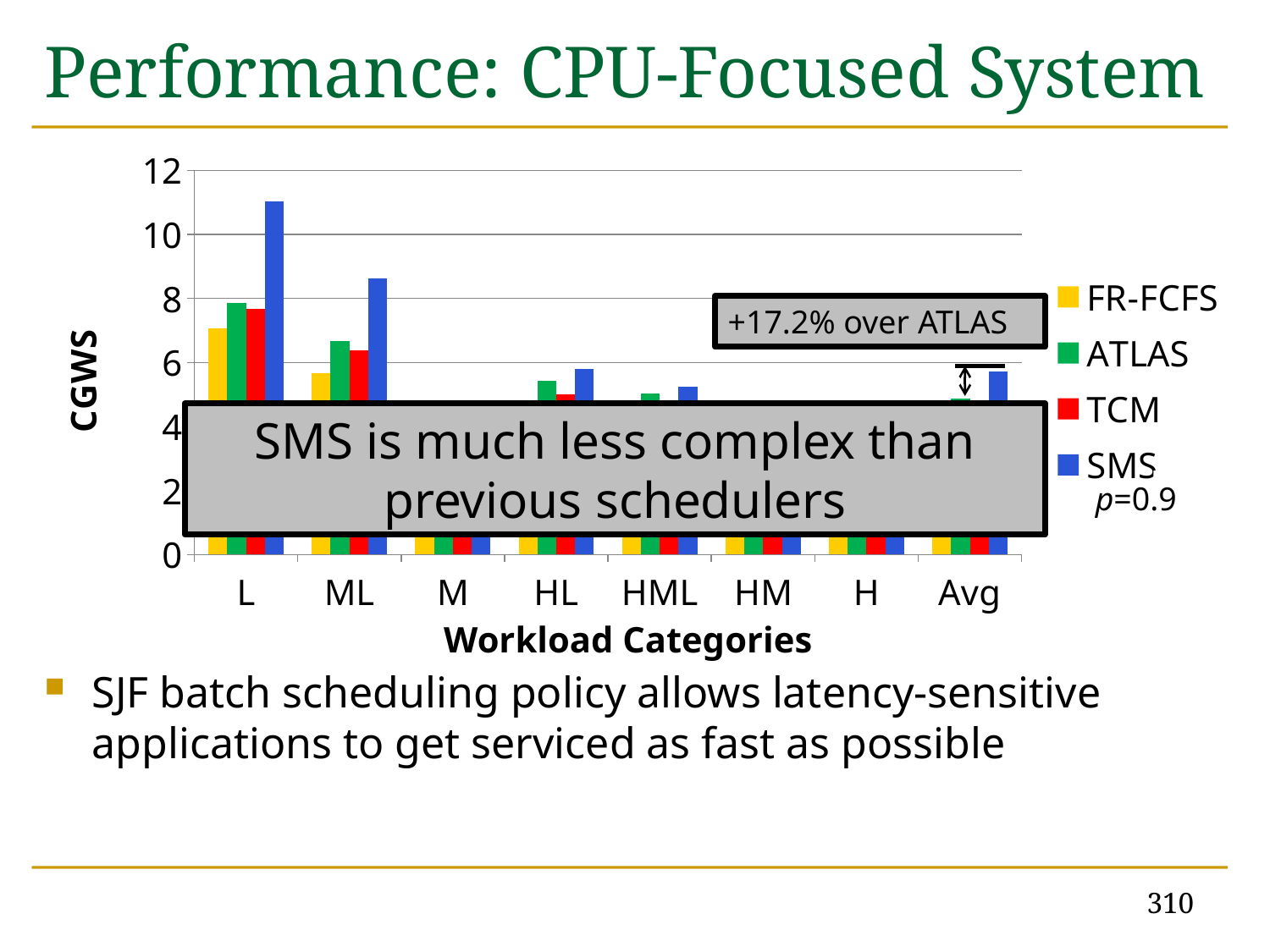
How many workload categories are shown on the x axis? 8 Is the SMS value for workload category L greater or less than 10? greater What kind of chart is shown on the slide? bar chart For workload category L, which is larger, the SMS value or the FR-FCFS value? SMS What is the label of the y axis? CGWS For workload category ML, which is larger, the SMS value or the TCM value? SMS How many series does the legend list? 4 Is the FR-FCFS value for workload category L greater or less than 8? less Is the ATLAS value for workload category ML greater or less than 6? greater Which workload category has the highest SMS value? L By what percentage does the annotation say SMS improves over ATLAS? +17.2%